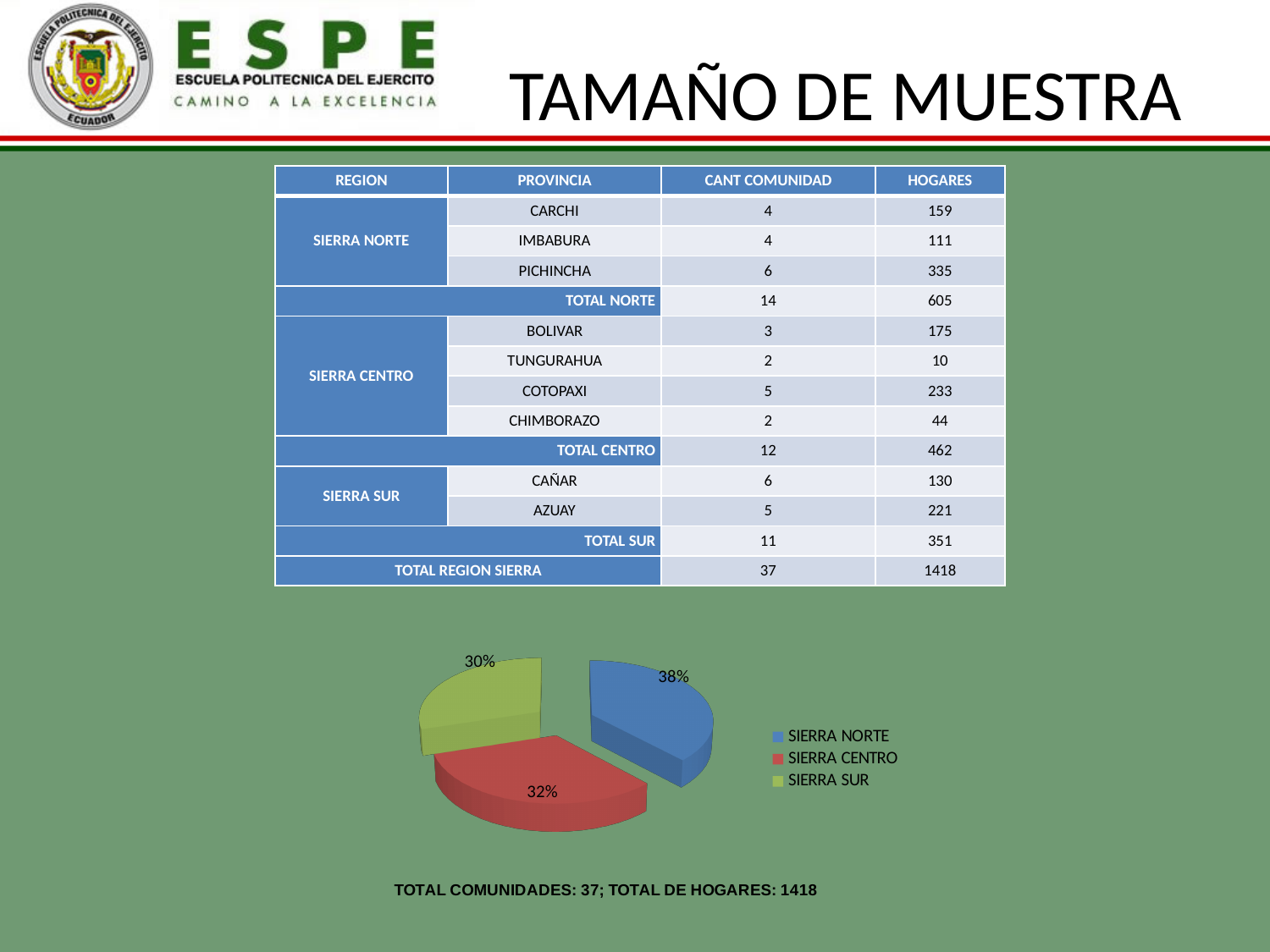
How many entries does the pie chart legend list? 3 What share of the pie does SIERRA SUR represent? 30% Which region has the largest slice of the pie? SIERRA NORTE What kind of chart is shown on the slide? pie chart Which region has the smallest slice of the pie? SIERRA SUR What colour is the SIERRA CENTRO slice in the pie chart? red What is the difference in percentage points between the SIERRA NORTE and SIERRA SUR slices? 8 How many slices does the pie chart have? 3 Which slice is larger, SIERRA CENTRO or SIERRA SUR? SIERRA CENTRO What share of the pie does SIERRA NORTE represent? 38% What colour is the SIERRA NORTE slice in the pie chart? blue What share of the pie does SIERRA CENTRO represent? 32%